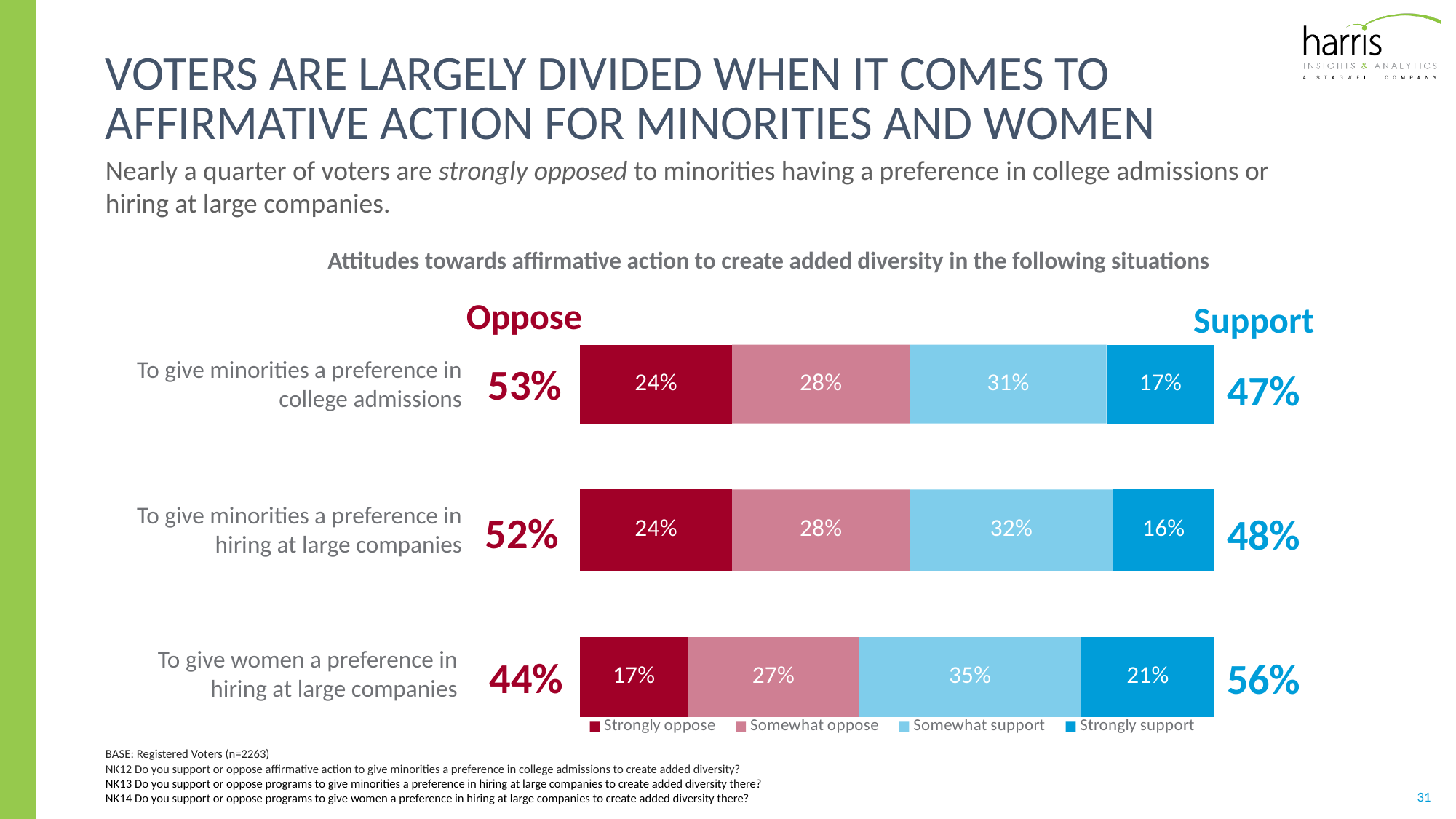
What percentage of voters strongly oppose giving minorities a preference in college admissions? 24% How many series does the legend list? 4 What percentage of voters strongly support giving minorities a preference in hiring at large companies? 16% What is the title of the chart? Attitudes towards affirmative action to create added diversity in the following situations What is the total Support percentage shown for giving women a preference in hiring at large companies? 56% Which situation has the highest Strongly support percentage? To give women a preference in hiring at large companies What kind of chart is shown on the slide? Stacked bar chart What percentage of voters somewhat support giving women a preference in hiring at large companies? 35% How many situations (bars) are shown in the chart? 3 Which is larger: the Strongly oppose percentage for giving minorities a preference in college admissions or for giving women a preference in hiring at large companies? To give minorities a preference in college admissions Which situation has the lowest total Oppose percentage? To give women a preference in hiring at large companies What is the difference between the Somewhat support percentages for giving women a preference in hiring and giving minorities a preference in college admissions? 4%